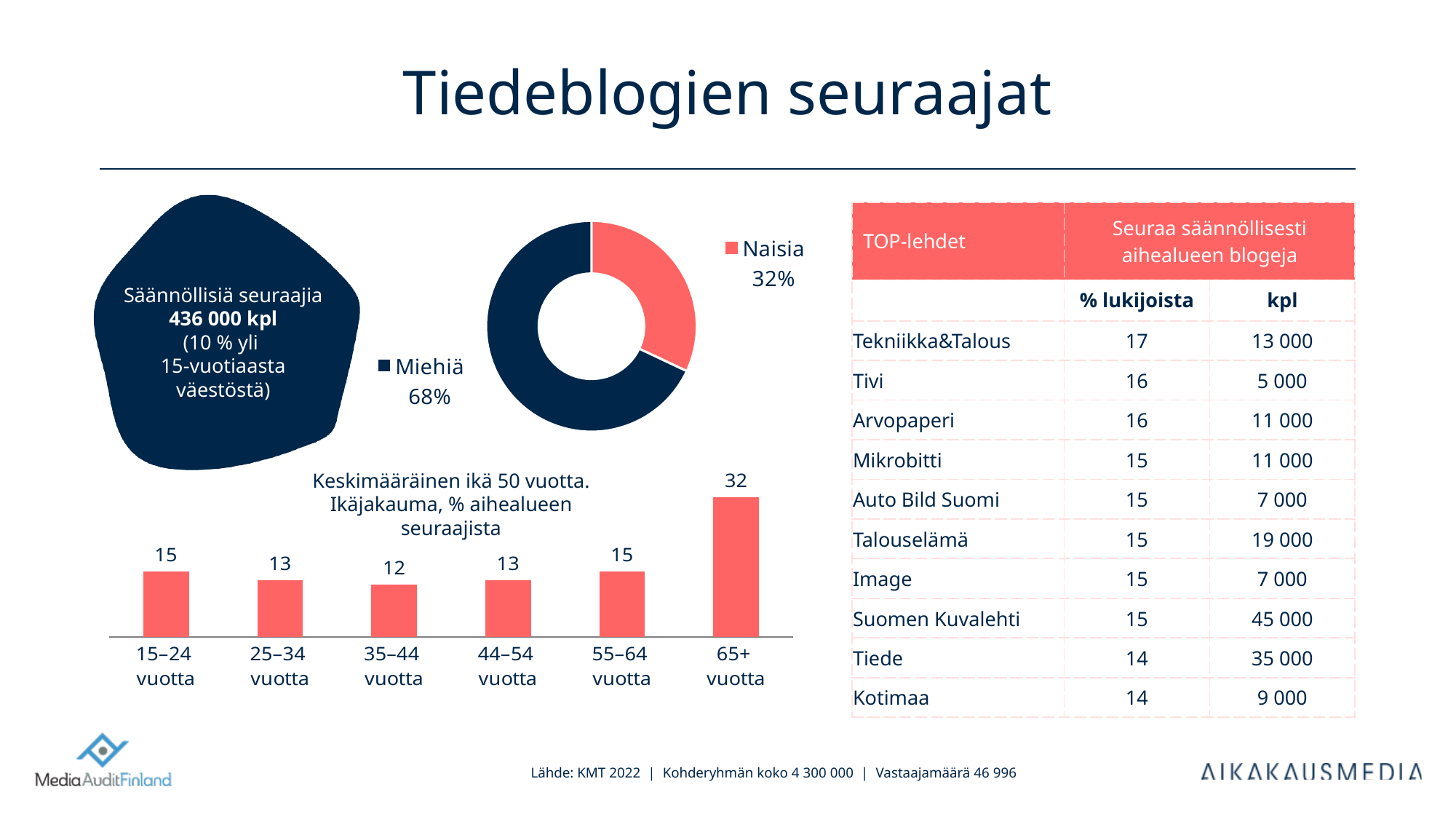
In the donut chart, which segment is larger, Miehiä or Naisia? Miehiä What type of chart is used to show the age distribution? Bar chart In the age distribution bar chart, what is the value for 35–44 vuotta? 12 In the donut chart, what share is shown for Miehiä? 68% In the donut chart, what share is shown for Naisia? 32% In the age distribution bar chart, is the value for 25–34 vuotta larger or smaller than the value for 55–64 vuotta? Smaller How many age groups are shown in the age distribution bar chart? 6 In the age distribution bar chart, which age group has the lowest value? 35–44 vuotta In the age distribution bar chart, what is the difference between the values for 65+ vuotta and 15–24 vuotta? 17 In the age distribution bar chart, which age group has the highest value? 65+ vuotta How many segments does the donut chart have? 2 In the age distribution bar chart, what is the value for 65+ vuotta? 32